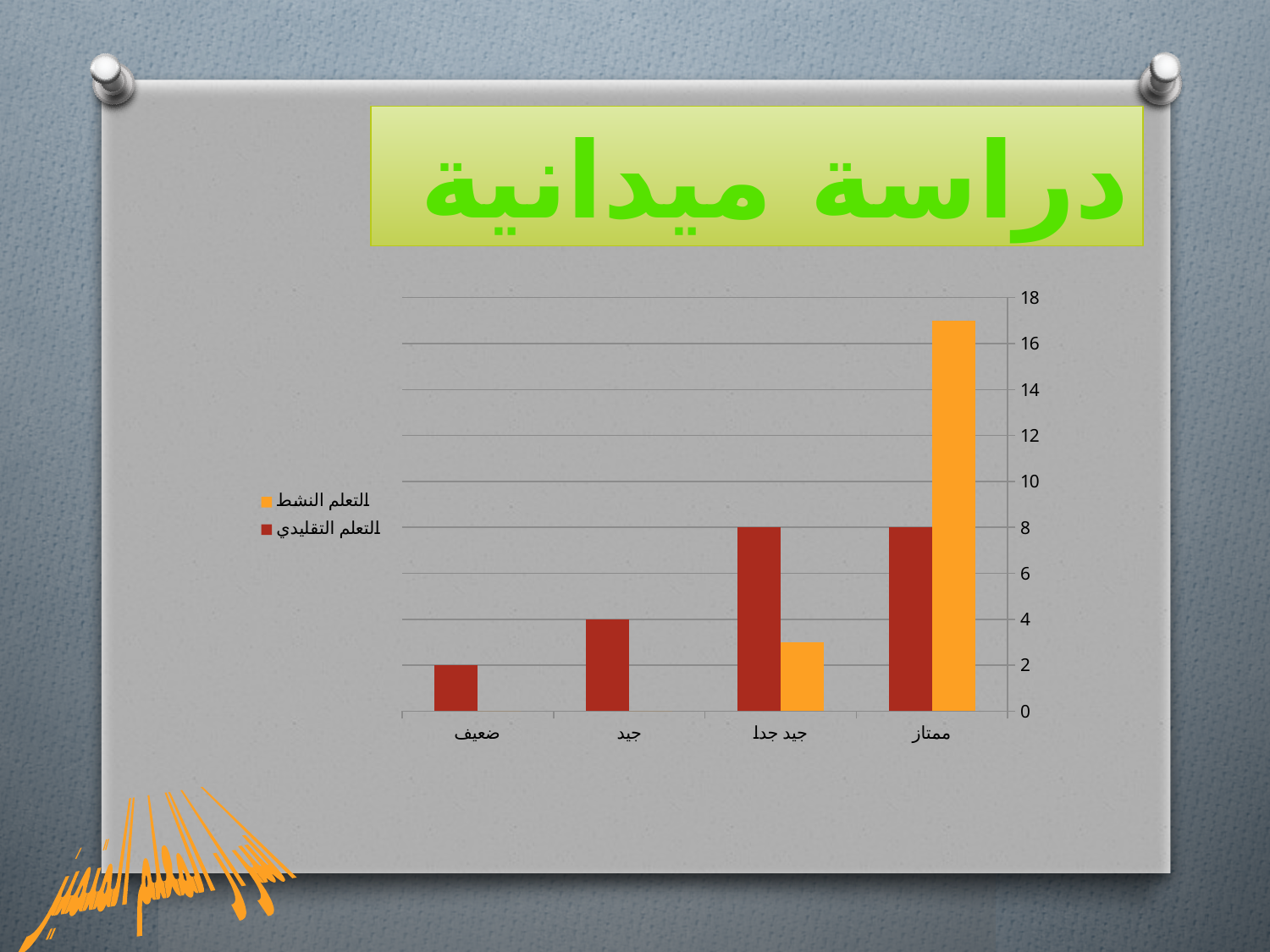
How many categories are shown on the x axis? 4 What is the value of التعلم التقليدي for ضعيف? 2 What is the title of the slide above the chart? دراسة ميدانية What type of chart is shown on the slide? bar chart For جيد جدا, which series has the larger value, التعلم النشط or التعلم التقليدي? التعلم التقليدي What is the difference between the التعلم التقليدي values for جيد جدا and ضعيف? 6 What is the value of التعلم التقليدي for ممتاز? 8 Which series is shown in orange according to the legend? التعلم النشط Is the value of التعلم النشط for ممتاز greater or less than 16? greater Which category has the tallest bar in the chart? ممتاز What is the value of التعلم التقليدي for جيد? 4 How many series does the legend list? 2